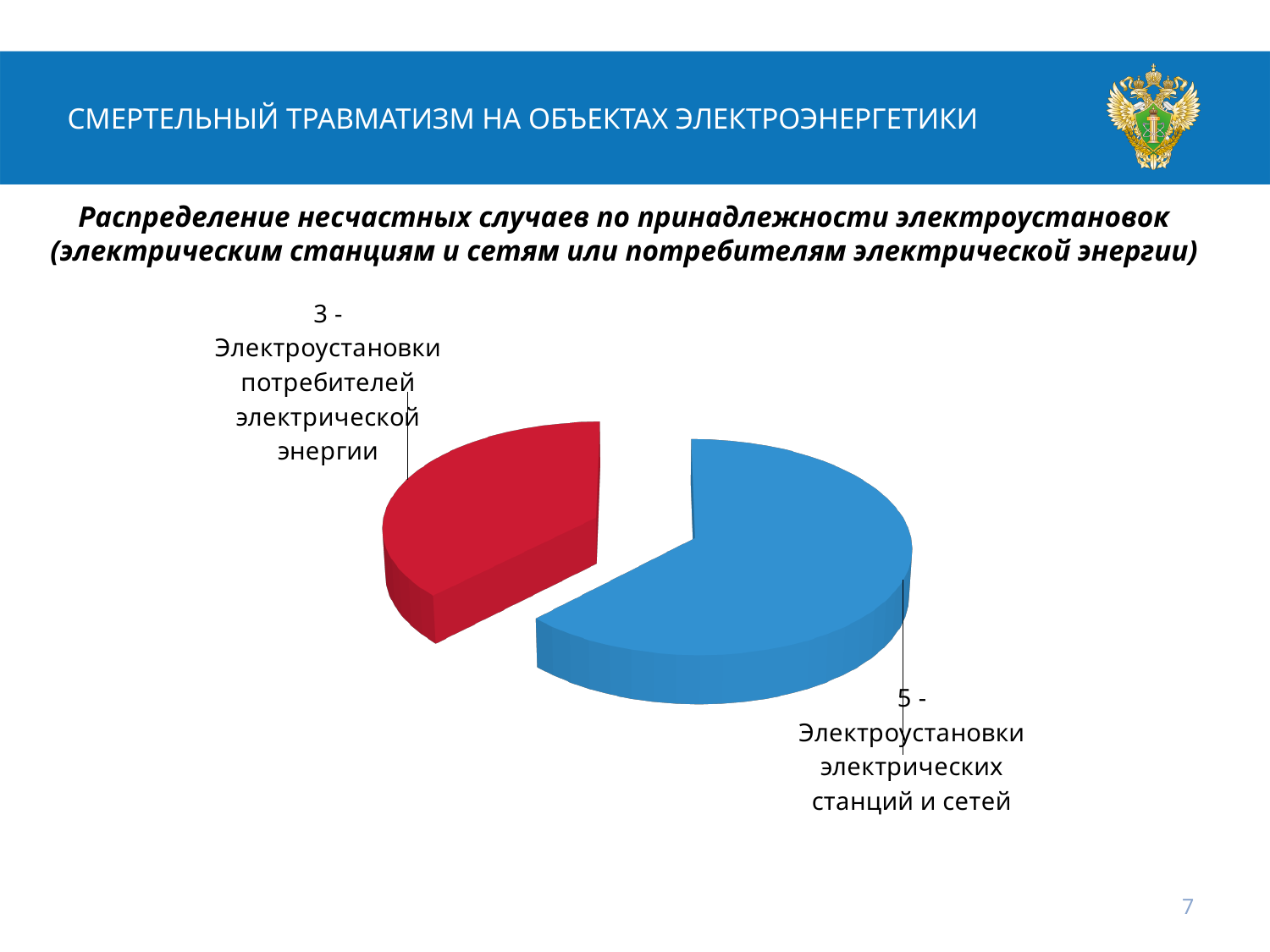
What colour is the slice for "Электроустановки потребителей электрической энергии"? Red How many slices does the pie chart have? 2 What is the value for "Электроустановки потребителей электрической энергии"? 3 What is the value for "Электроустановки электрических станций и сетей"? 5 Which is larger: the value for "Электроустановки электрических станций и сетей" or the value for "Электроустановки потребителей электрической энергии"? Электроустановки электрических станций и сетей What kind of chart is shown on the slide? Pie chart Which category has the largest slice of the pie? Электроустановки электрических станций и сетей What is the total of all slices in the pie chart? 8 What is the difference between the value for "Электроустановки электрических станций и сетей" and the value for "Электроустановки потребителей электрической энергии"? 2 What share of the pie does "Электроустановки электрических станций и сетей" represent? 62.5% Which category has the smallest slice of the pie? Электроустановки потребителей электрической энергии What share of the pie does "Электроустановки потребителей электрической энергии" represent? 37.5%